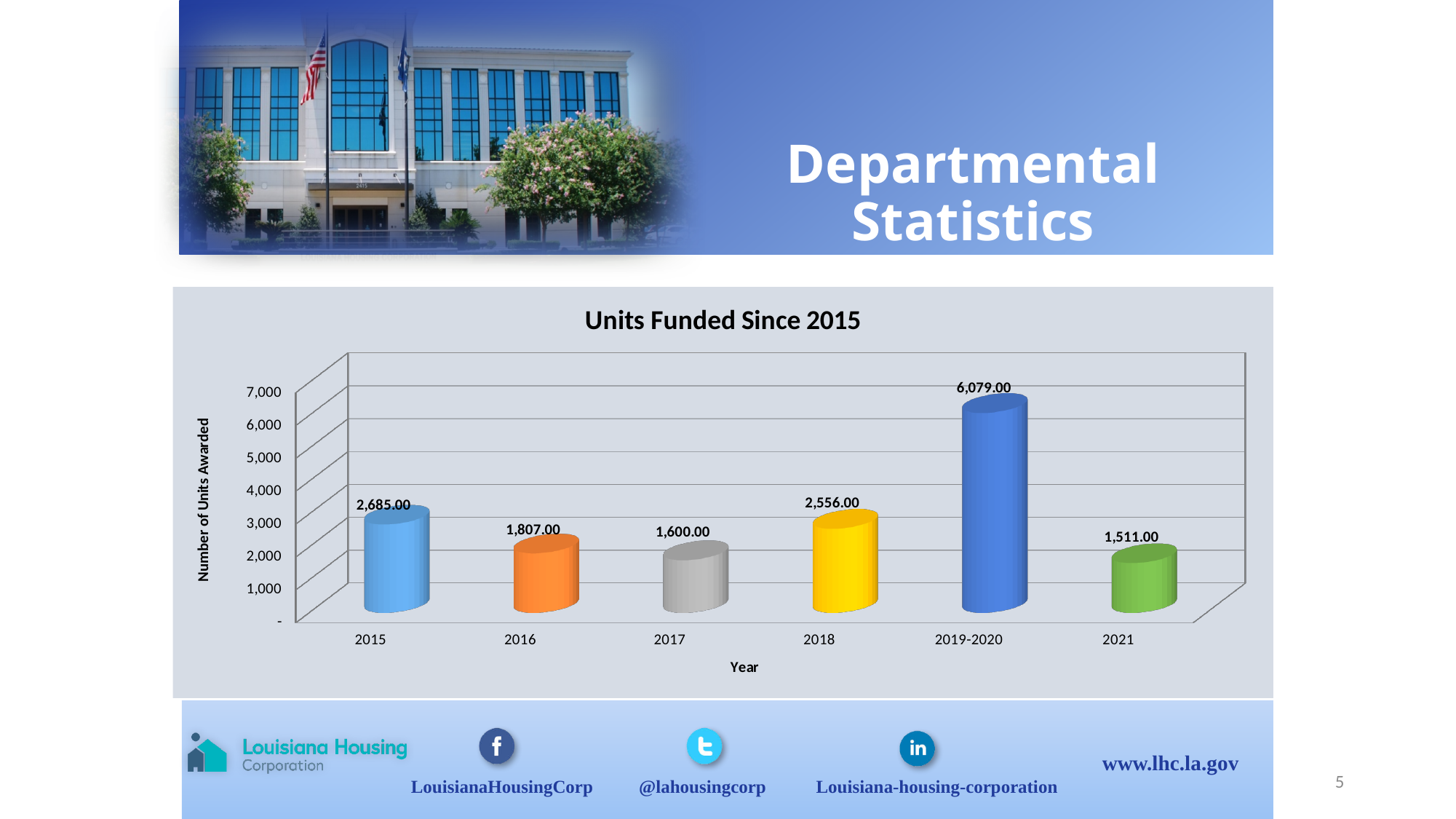
What kind of chart is shown on the slide? bar chart What is the difference between the values for 2019-2020 and 2018? 3,523.00 What is the title of the chart? Units Funded Since 2015 How many year categories are shown on the x axis? 6 Is the value for 2019-2020 greater or less than 5,000? greater What is the difference between the values for 2015 and 2016? 878.00 What is the value for 2021 in the Units Funded Since 2015 chart? 1,511.00 What is the value for 2015 in the Units Funded Since 2015 chart? 2,685.00 Which is larger, the value for 2017 or the value for 2018? 2018 Which year has the highest number of units awarded? 2019-2020 Which year has the lowest number of units awarded? 2021 What is the value for 2019-2020 in the Units Funded Since 2015 chart? 6,079.00